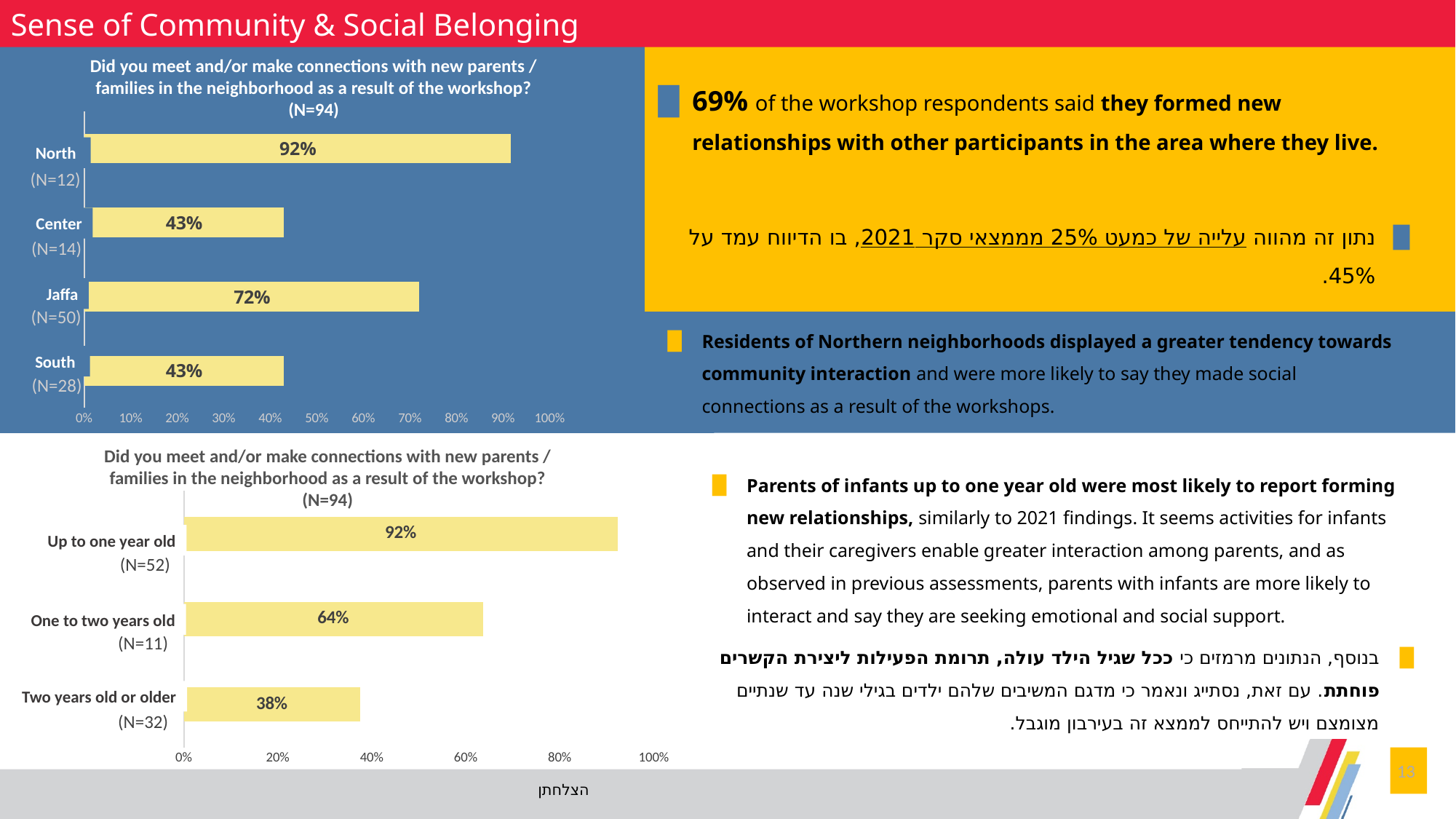
In the bottom chart (by child age), what is the value for One to two years old? 64% In the top chart (by region), what percentage of North respondents said they made connections with new parents/families? 92% In the bottom chart (by child age), do the values rise or fall as the child's age increases? fall What type of chart is the bottom chart (by child age)? bar chart In the top chart (by region), which region has the highest percentage? North In the top chart (by region), what is the difference between the values for North and Jaffa? 20 percentage points In the top chart (by region), is the value for Jaffa greater or less than 50%? greater In the top chart (by region), what is the sample size (N) for Jaffa? 50 In the top chart (by region), how many regions are shown? 4 In the bottom chart (by child age), which age group has the lowest percentage? Two years old or older In the bottom chart (by child age), what is the difference between the values for Up to one year old and Two years old or older? 54 percentage points In the top chart (by region), what is the value for Jaffa? 72%